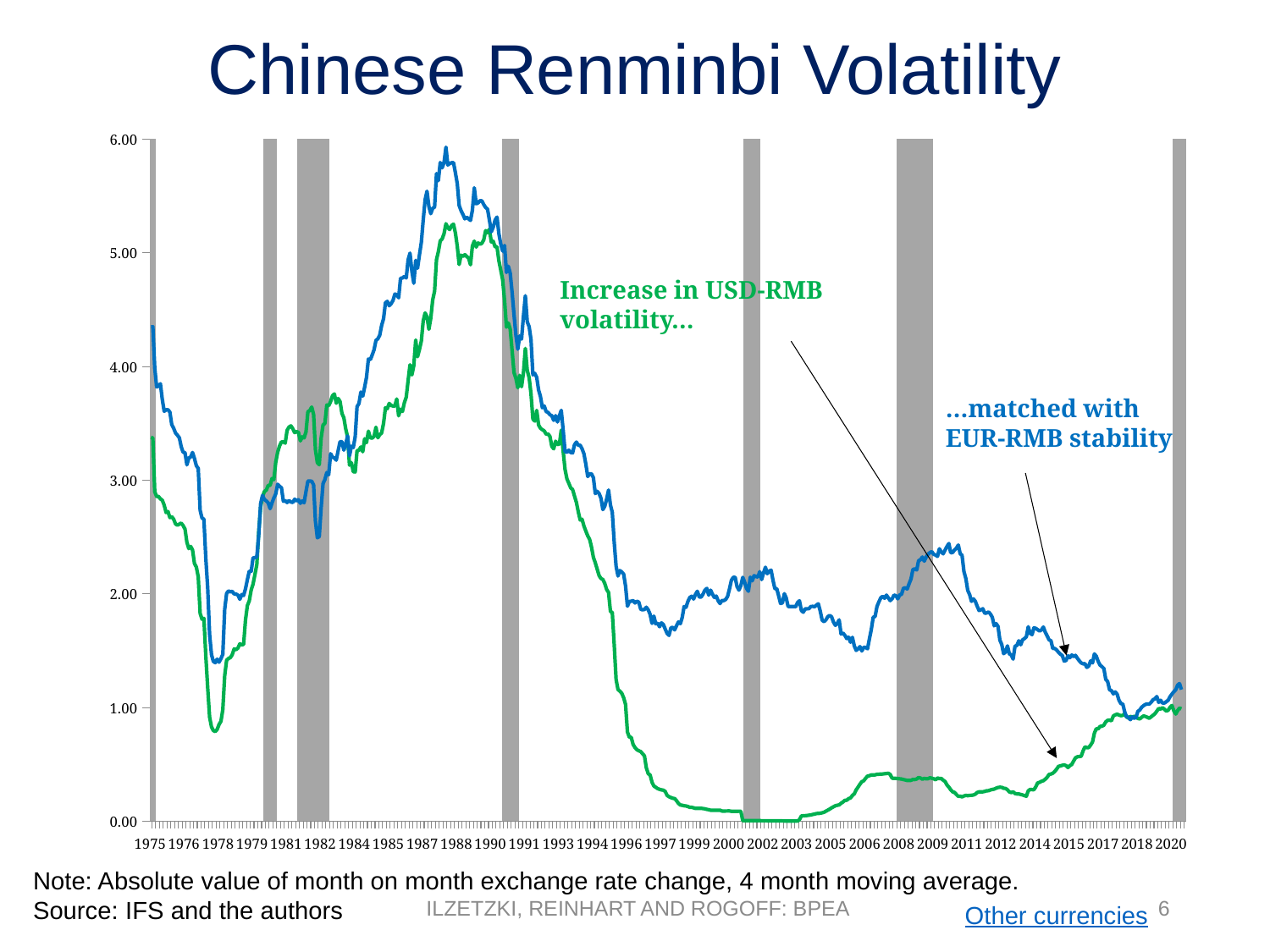
In 2000, which line is higher, the blue EUR-RMB line or the green USD-RMB line? blue EUR-RMB line Is the value of the blue EUR-RMB line in 2010 greater or less than 2.00? greater What is the title of the chart? Chinese Renminbi Volatility How many lines are plotted on the chart? 2 Does the green USD-RMB line rise or fall between 1993 and 2003? fall Is the value of the green USD-RMB line in 2003 greater or less than 1.00? less What kind of chart is shown on the slide? line chart Does the blue EUR-RMB line rise or fall between 2010 and 2018? fall Is the peak value of the blue EUR-RMB line around 1988 greater or less than 5.00? greater Which colour line represents USD-RMB volatility? green